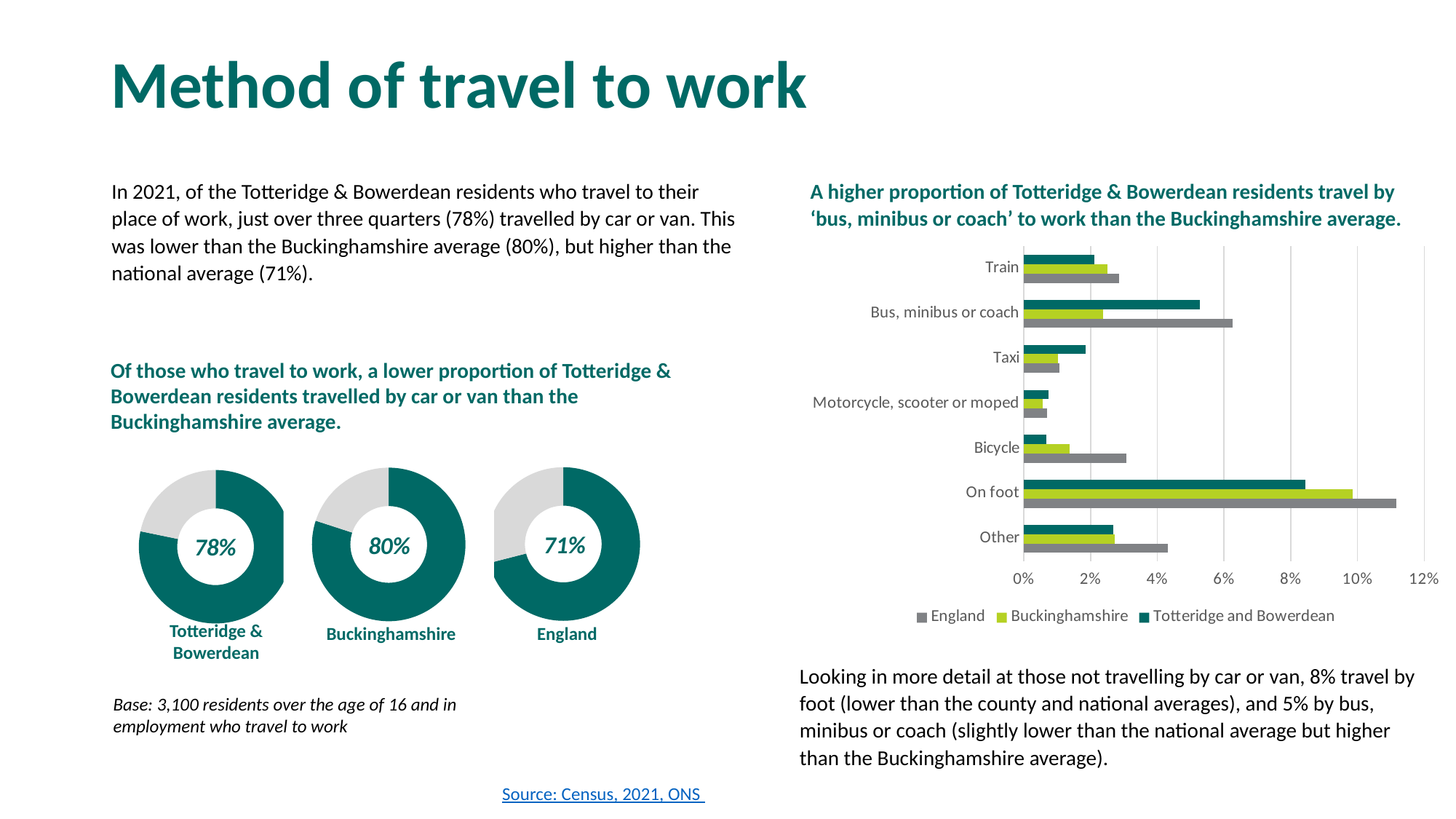
In the bar chart on the right, is the England value for On foot greater or less than 10%? greater In the donut charts, what is the difference between the Buckinghamshire value and the Totteridge & Bowerdean value? 2% In the bar chart on the right, how many travel method categories are shown? 7 In the bar chart on the right, is the Totteridge and Bowerdean value for Bus, minibus or coach greater or less than 4%? greater What kind of chart is the chart on the right of the slide showing methods of travel such as Train and Bus, minibus or coach? Bar chart In the donut charts, what percentage of Totteridge & Bowerdean residents travelled to work by car or van? 78% In the bar chart on the right, how many series does the legend list? 3 Among the three donut charts, which area has the highest percentage travelling by car or van? Buckinghamshire In the donut charts, what is the value shown for England? 71% In the bar chart on the right, which category has the highest England value? On foot In the donut charts, what is the value shown for Buckinghamshire? 80% Among the three donut charts, which area has the lowest percentage travelling by car or van? England